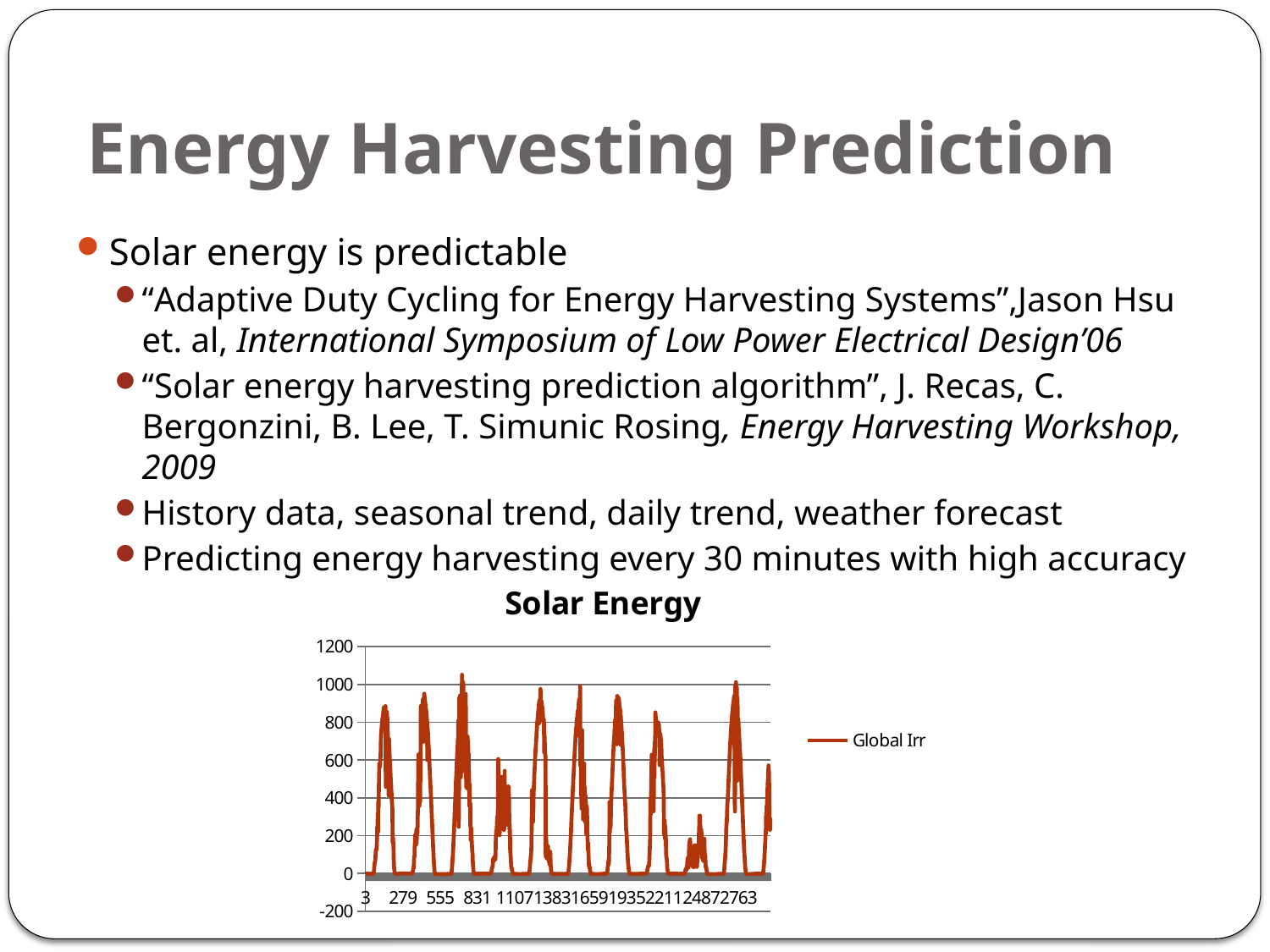
What kind of chart is shown under the title "Solar Energy"? line chart Is the lowest value reached by the Global Irr line greater or less than 200? less What is the title of the chart on the slide? Solar Energy Is the highest peak reached by the Global Irr line greater or less than 800? greater What is the lowest value shown on the y axis of the Solar Energy chart? -200 Does the Global Irr line rise steadily, fall steadily, or repeatedly rise and fall along the x axis? repeatedly rise and fall What is the first label on the x axis of the Solar Energy chart? 3 What is the last label on the x axis of the Solar Energy chart? 2763 How many series does the legend of the Solar Energy chart list? 1 How many tick labels are printed along the x axis of the Solar Energy chart? 11 What is the highest value shown on the y axis of the Solar Energy chart? 1200 What is the name of the series shown in the legend of the Solar Energy chart? Global Irr